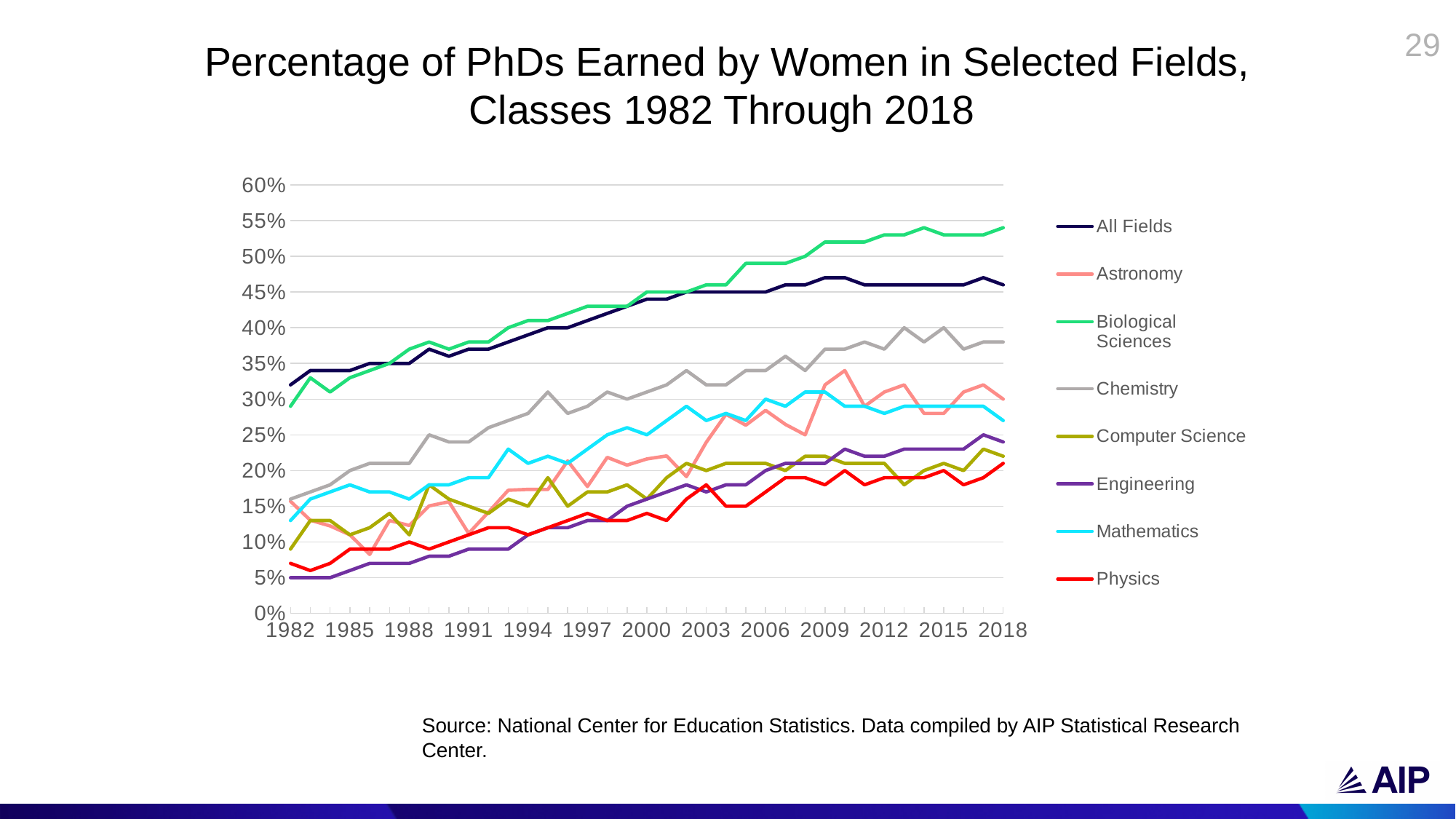
Which field has the highest percentage of PhDs earned by women in 2018? Biological Sciences Is the value for Chemistry in 2018 greater or less than 35%? greater Which field has the lowest percentage of PhDs earned by women in 1982? Engineering What kind of chart is shown on the slide? line chart In 2018, which is larger: the value for Biological Sciences or the value for All Fields? Biological Sciences How many series does the legend list? 8 Is the value for Mathematics in 2018 greater or less than 30%? less In 2018, which is larger: the value for Chemistry or the value for Astronomy? Chemistry What is the title of the chart? Percentage of PhDs Earned by Women in Selected Fields, Classes 1982 Through 2018 Does the All Fields line generally rise or fall from 1982 to 2018? rise Is the value for Biological Sciences in 2018 greater or less than 50%? greater